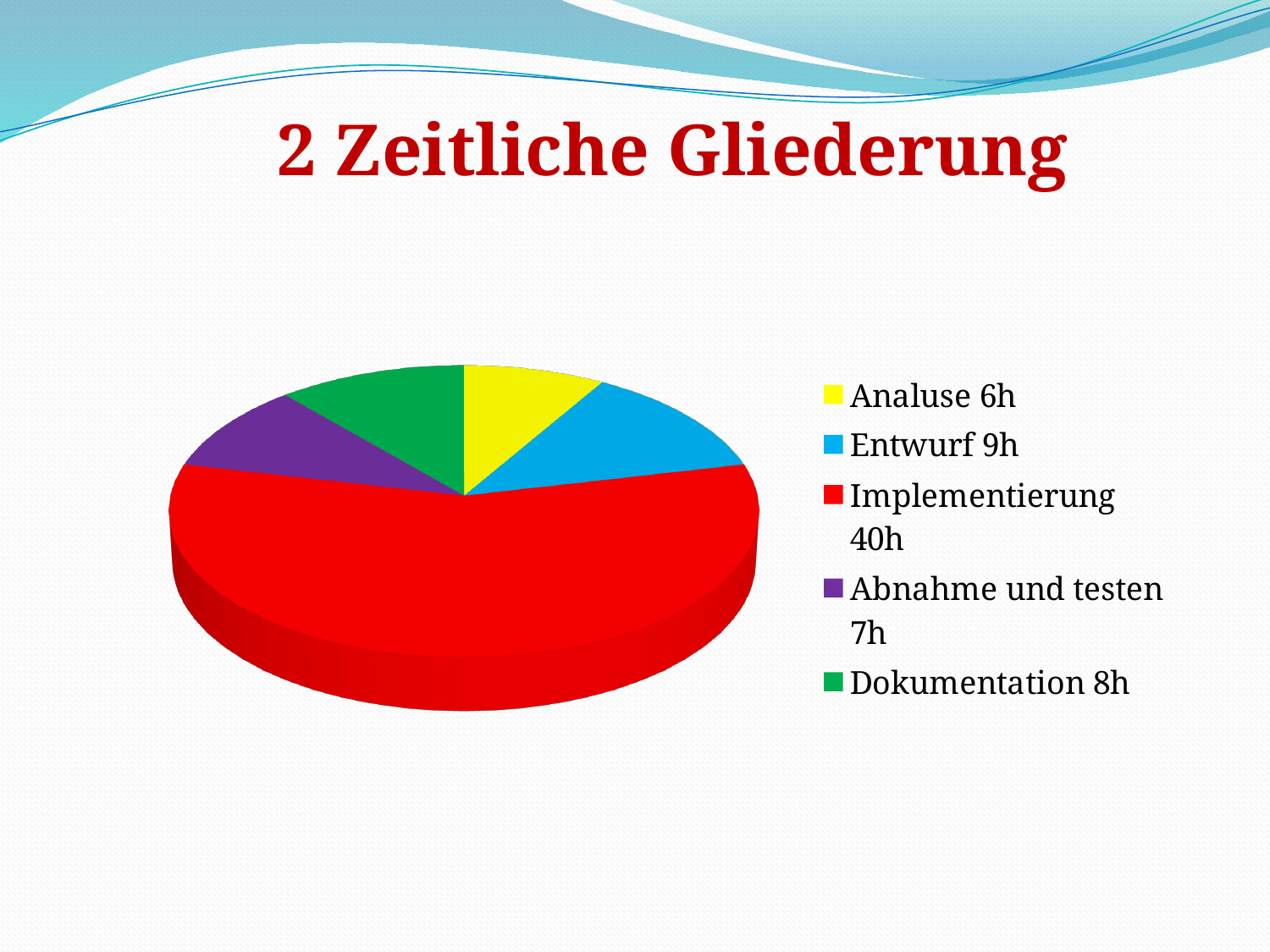
Which category has the smallest slice of the pie? Analuse What is the difference in hours between Implementierung and Entwurf? 31h How many slices does the pie chart have? 5 Which category has the largest slice of the pie? Implementierung What is the title of the slide containing the pie chart? 2 Zeitliche Gliederung How many hours are shown for Implementierung in the legend? 40h What kind of chart is shown on the slide? pie chart How many hours are shown for Abnahme und testen? 7h How many hours are shown for Dokumentation? 8h Which has more hours, Dokumentation or Abnahme und testen? Dokumentation How many hours are shown for Entwurf? 9h What colour is the slice for Analuse? yellow